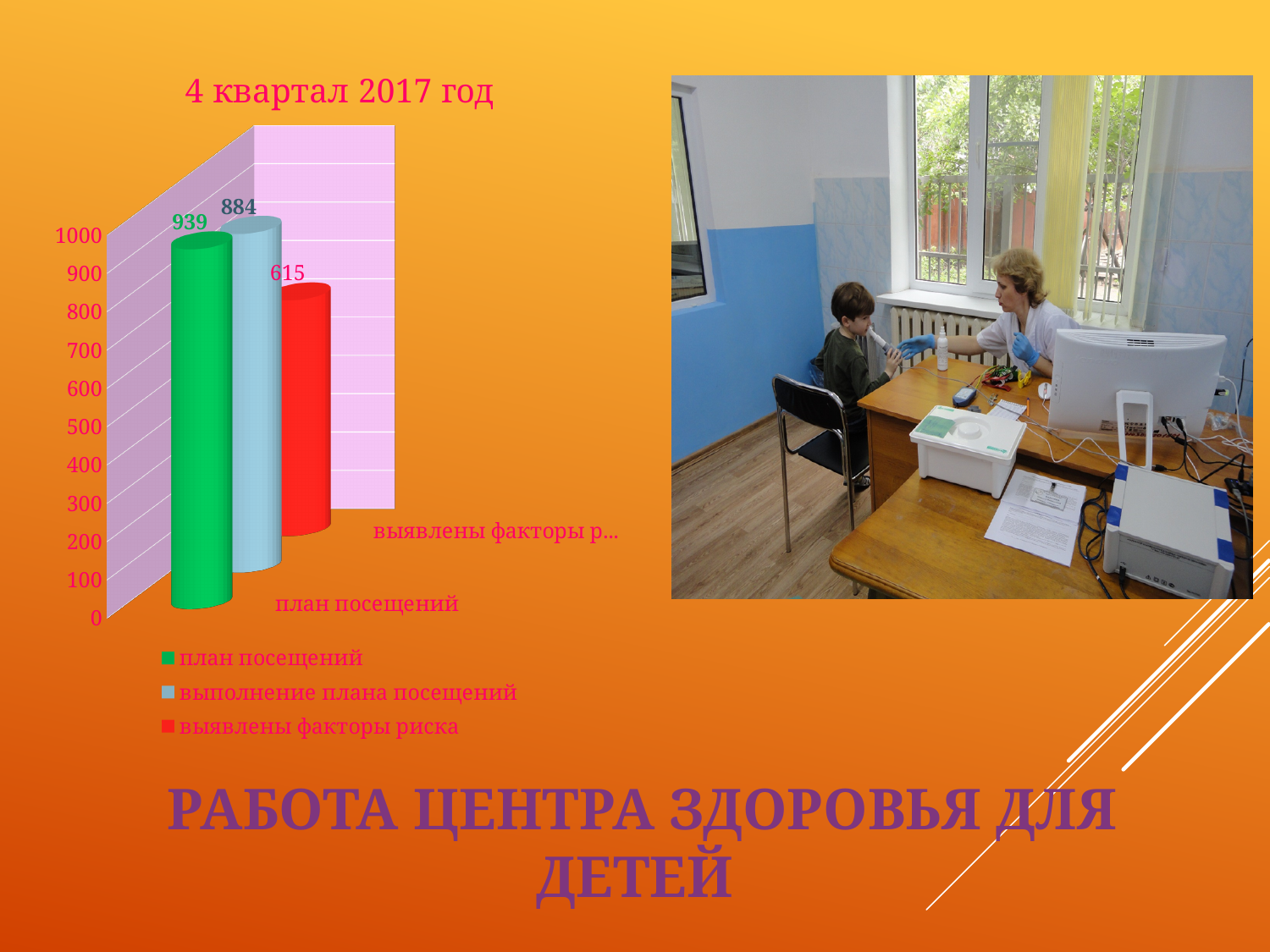
What is the title of the chart? 4 квартал 2017 год Is the value for выявлены факторы риска greater or less than 700? less What is the difference between план посещений and выполнение плана посещений? 55 Which series has the highest value? план посещений Which is larger, план посещений or выявлены факторы риска? план посещений Which series has the lowest value? выявлены факторы риска What is the value for план посещений? 939 How many series does the legend list? 3 What is the value for выполнение плана посещений? 884 What is the difference between выполнение плана посещений and выявлены факторы риска? 269 What is the value for выявлены факторы риска? 615 What type of chart is shown on the slide? bar chart